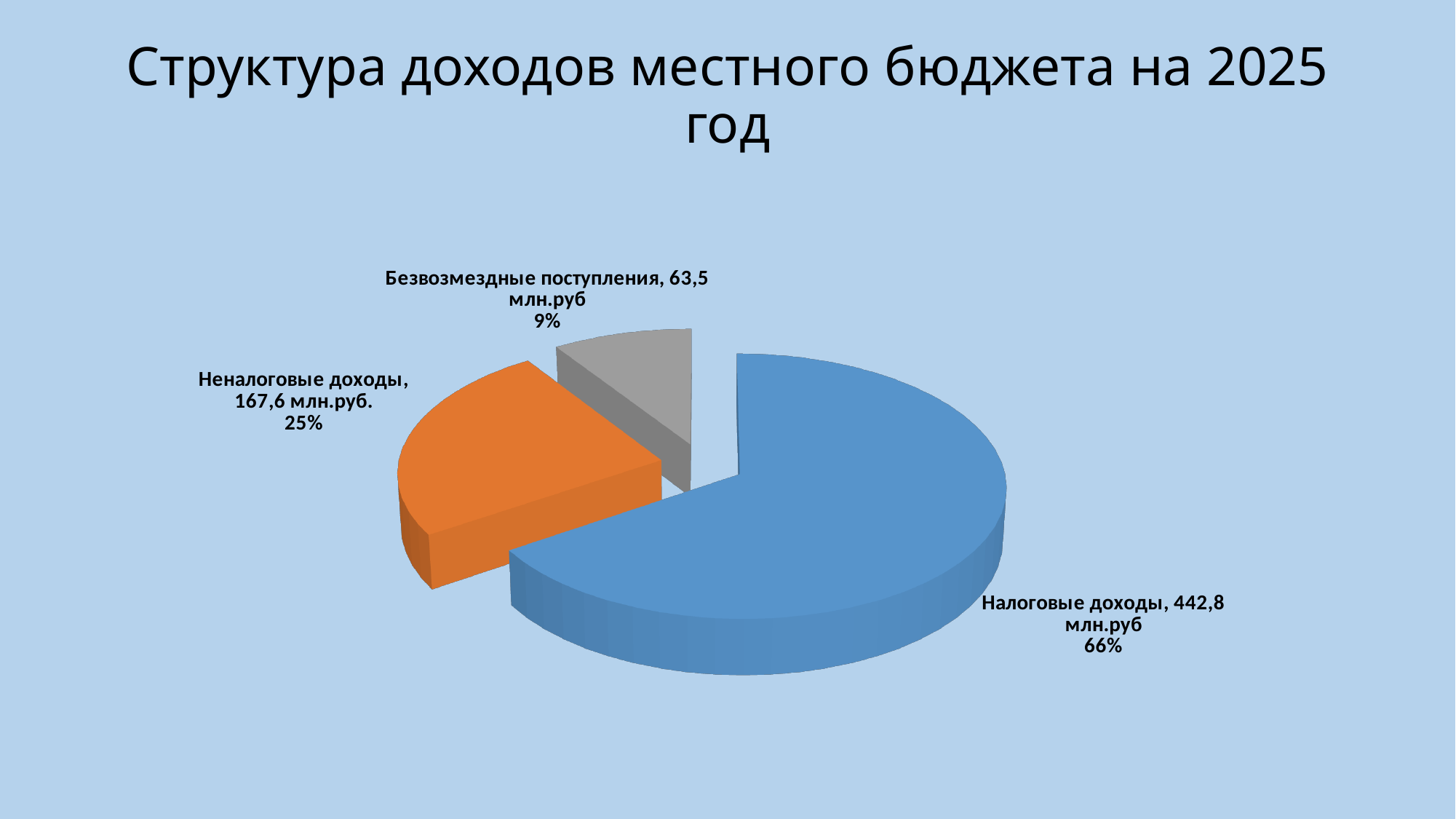
What is the value for Налоговые доходы? 442,8 млн.руб What share of the pie does Налоговые доходы represent? 66% How many categories are shown in the pie chart? 3 What kind of chart is shown on the slide? Pie chart What is the value for Безвозмездные поступления? 63,5 млн.руб What is the difference between Налоговые доходы and Неналоговые доходы in млн.руб? 275,2 млн.руб Which is larger, Неналоговые доходы or Безвозмездные поступления? Неналоговые доходы What share of the pie does Безвозмездные поступления represent? 9% Which category has the largest slice? Налоговые доходы Which category has the smallest slice? Безвозмездные поступления What is the value for Неналоговые доходы? 167,6 млн.руб. What share of the pie does Неналоговые доходы represent? 25%